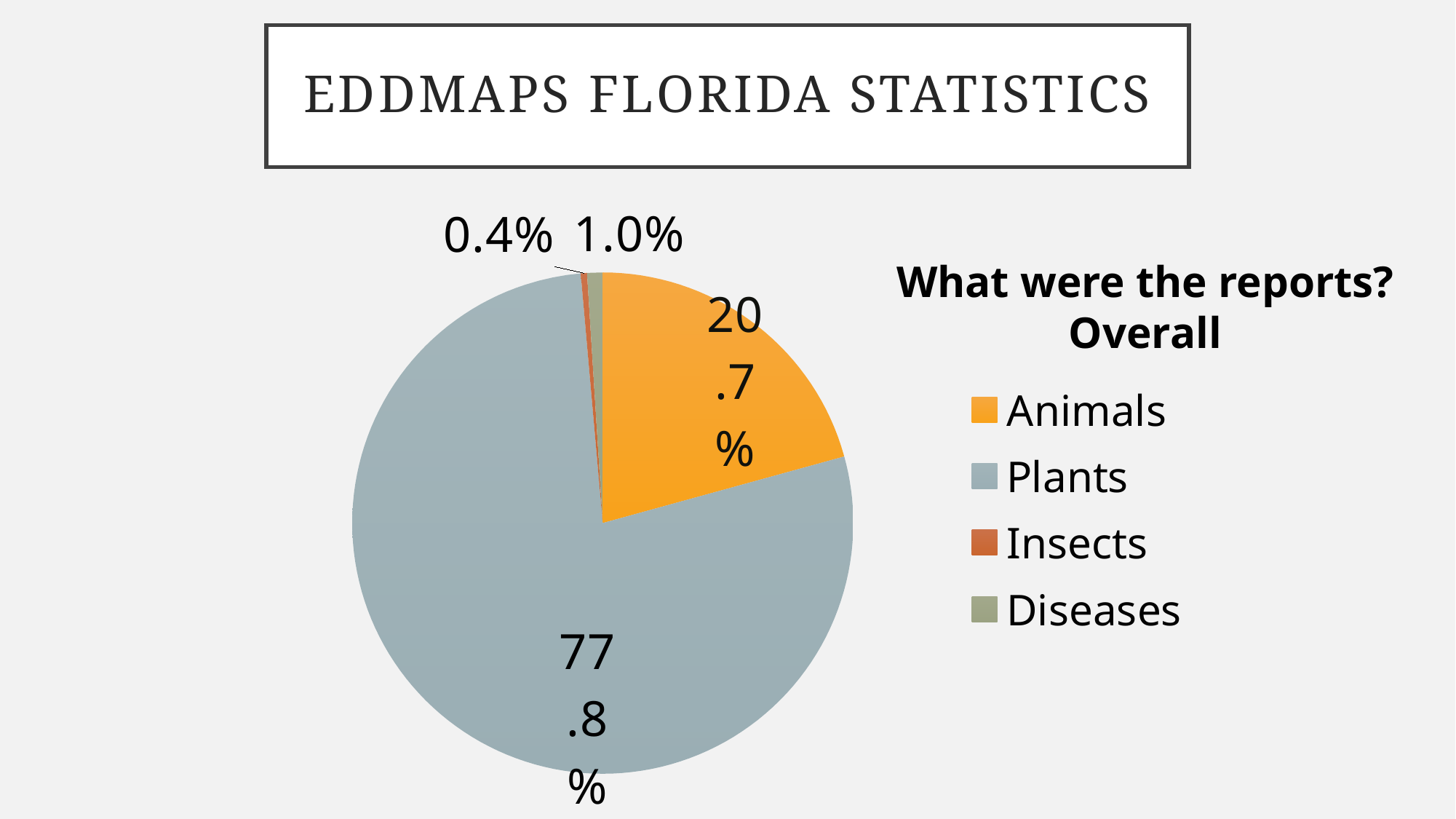
What share of the pie does Plants account for? 77.8% What is the difference in percentage points between the Plants and Animals slices? 57.1 What is the title of the pie chart? What were the reports? Overall Which colour represents Animals in the pie chart? orange Which category has the largest slice of the pie? Plants What share of the pie does Insects account for? 0.4% What share of the pie does Animals account for? 20.7% Which is larger, the Animals slice or the Diseases slice? Animals What kind of chart is shown on the slide? pie chart How many categories does the pie chart show? 4 Which category has the smallest slice of the pie? Insects